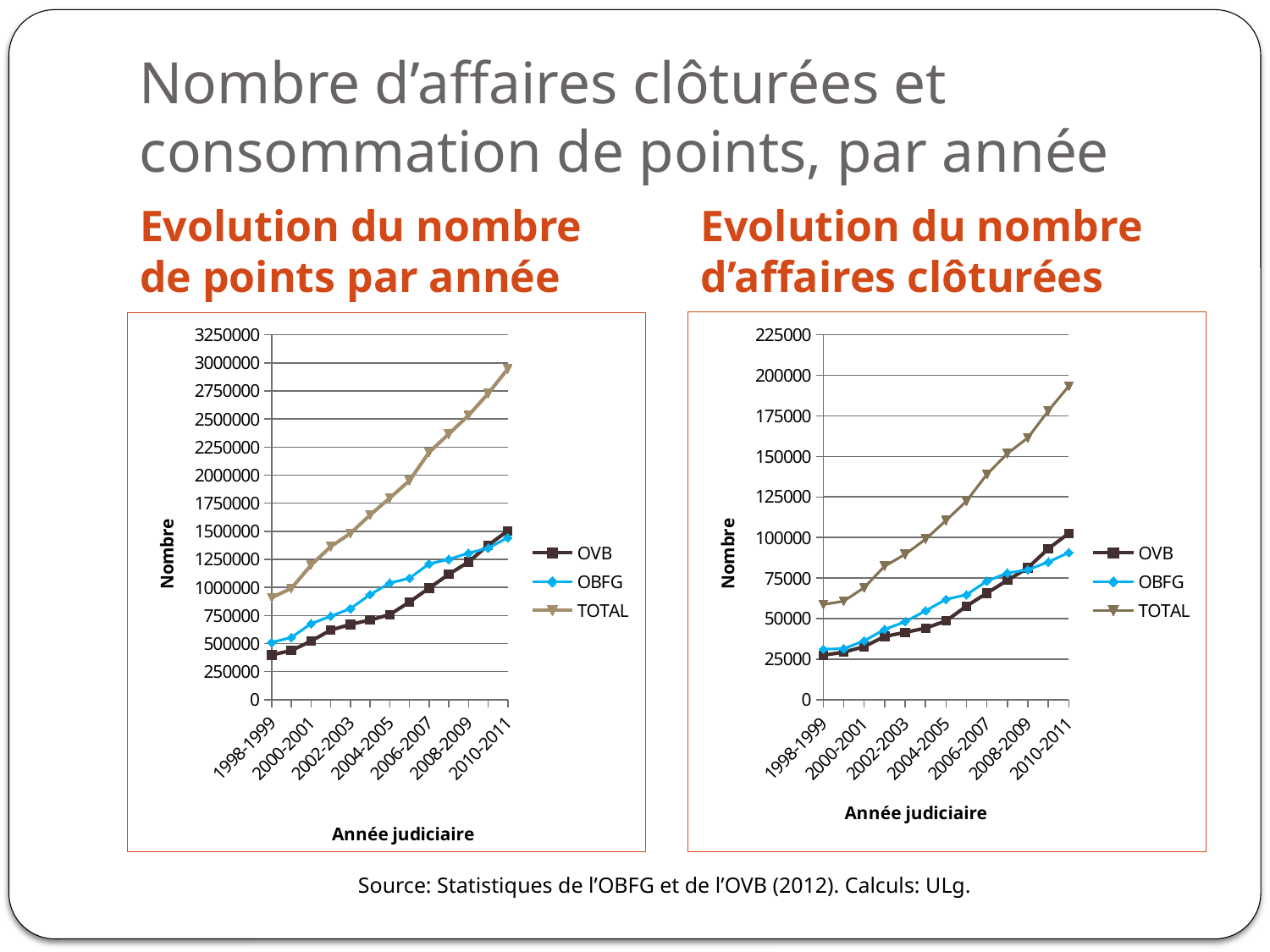
In the 'Evolution du nombre d'affaires clôturées' chart, does the TOTAL series rise or fall from 1998-1999 to 2010-2011? rise In the 'Evolution du nombre d'affaires clôturées' chart, is the TOTAL value for 1998-1999 greater or less than 50000? greater In the 'Evolution du nombre de points par année' chart, is the OVB value for 1998-1999 greater or less than 500000? less In the 'Evolution du nombre d'affaires clôturées' chart, is the OBFG value for 2010-2011 greater or less than 100000? less In the 'Evolution du nombre de points par année' chart, which series has the highest values across all years? TOTAL What is the label of the x axis on the 'Evolution du nombre de points par année' chart? Année judiciaire In the 'Evolution du nombre d'affaires clôturées' chart, which series is higher in 2010-2011, OVB or OBFG? OVB In the 'Evolution du nombre de points par année' chart, which series is higher in 1998-1999, OVB or OBFG? OBFG What kind of chart is the 'Evolution du nombre de points par année' chart? line chart How many series does the legend of the 'Evolution du nombre d'affaires clôturées' chart list? 3